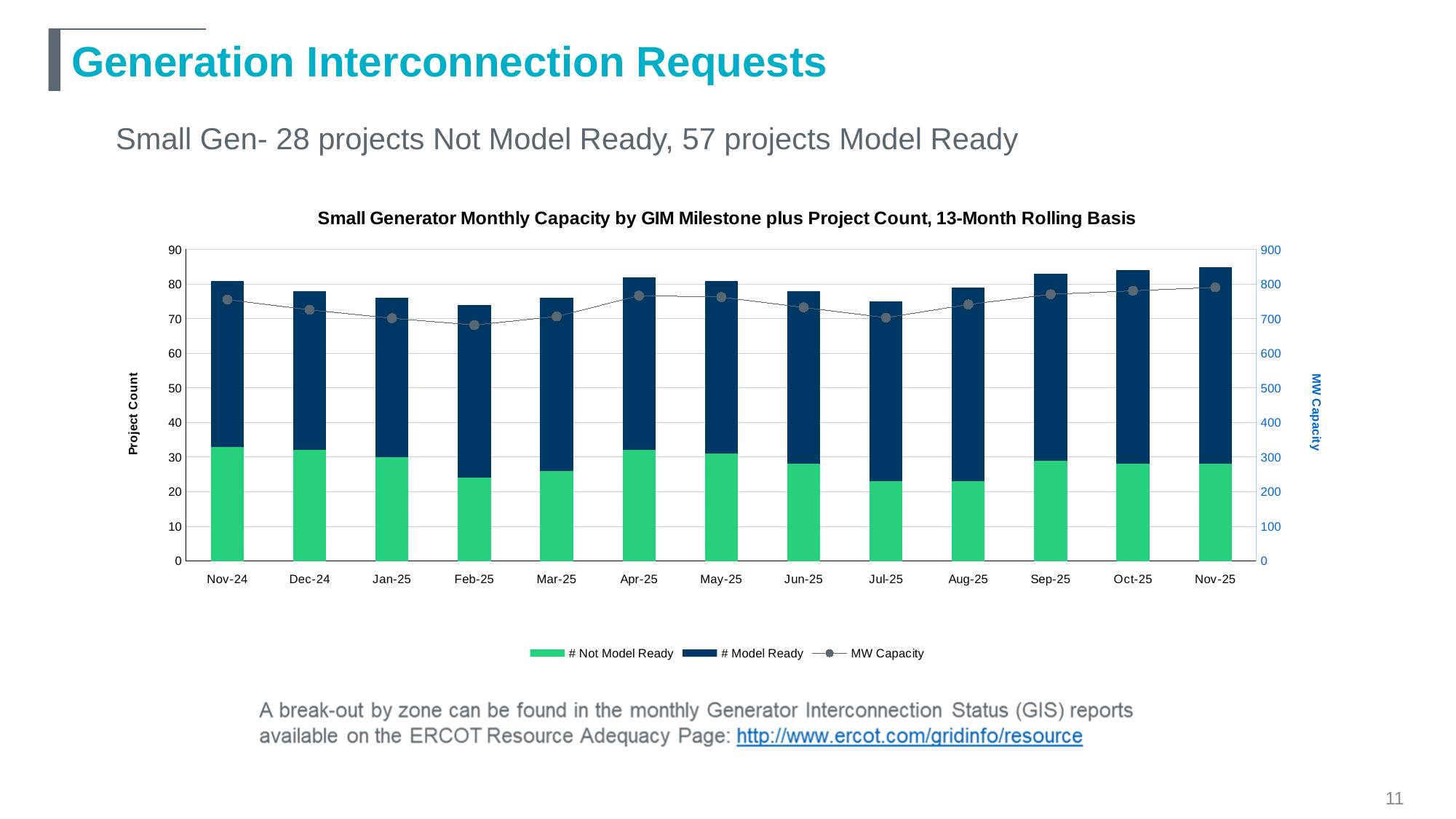
Is the total project count for Nov-25 greater or less than 80? greater Is the # Not Model Ready value for Jul-25 greater or less than 30? less What is the label of the right-hand vertical axis? MW Capacity Which is larger, the # Not Model Ready value for Nov-24 or for Feb-25? Nov-24 How many series does the chart legend list? 3 Does the MW Capacity line rise or fall from Jul-25 to Nov-25? rise What kind of chart is shown on the slide? Stacked bar chart with a line Which month has the lowest MW Capacity? Feb-25 What is the title of the chart? Small Generator Monthly Capacity by GIM Milestone plus Project Count, 13-Month Rolling Basis Is the total project count for Feb-25 greater or less than 80? less How many months are shown on the x axis of the chart? 13